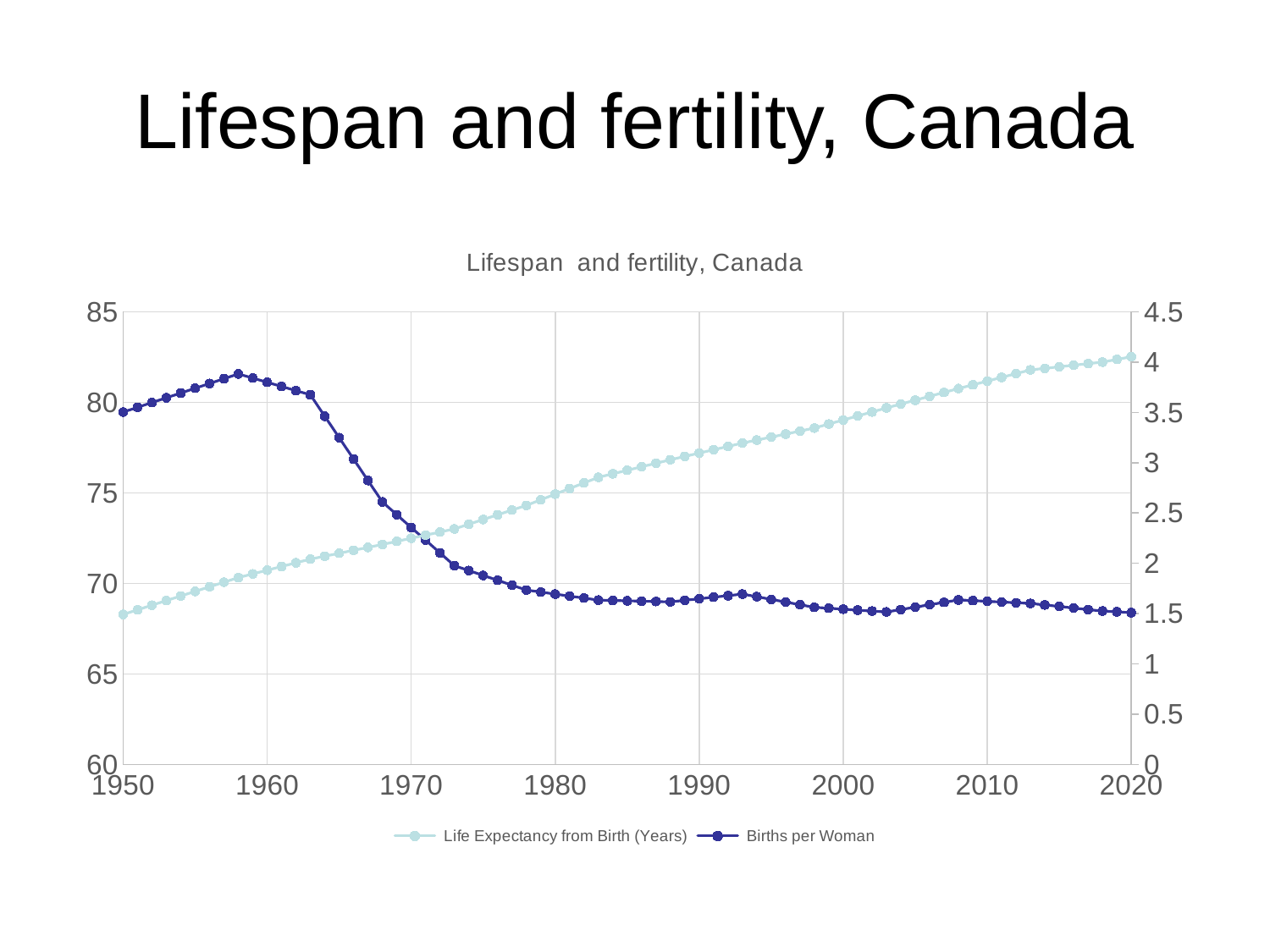
Which is larger, Births per Woman in 1950 or Births per Woman in 2000? 1950 Is the value for Births per Woman in 1960 greater or less than 3.5? greater What are the two series named in the legend? Life Expectancy from Birth (Years) and Births per Woman What kind of chart is shown on the slide? line chart What is the title of the chart? Lifespan and fertility, Canada In which year is Life Expectancy from Birth (Years) highest? 2020 Is the value for Births per Woman in 2020 greater or less than 2? less Does Life Expectancy from Birth (Years) rise or fall from 1950 to 2020? rise How many series does the legend list? 2 Does Births per Woman rise or fall between 1960 and 1980? fall Is the value for Life Expectancy from Birth (Years) in 1950 greater or less than 70? less